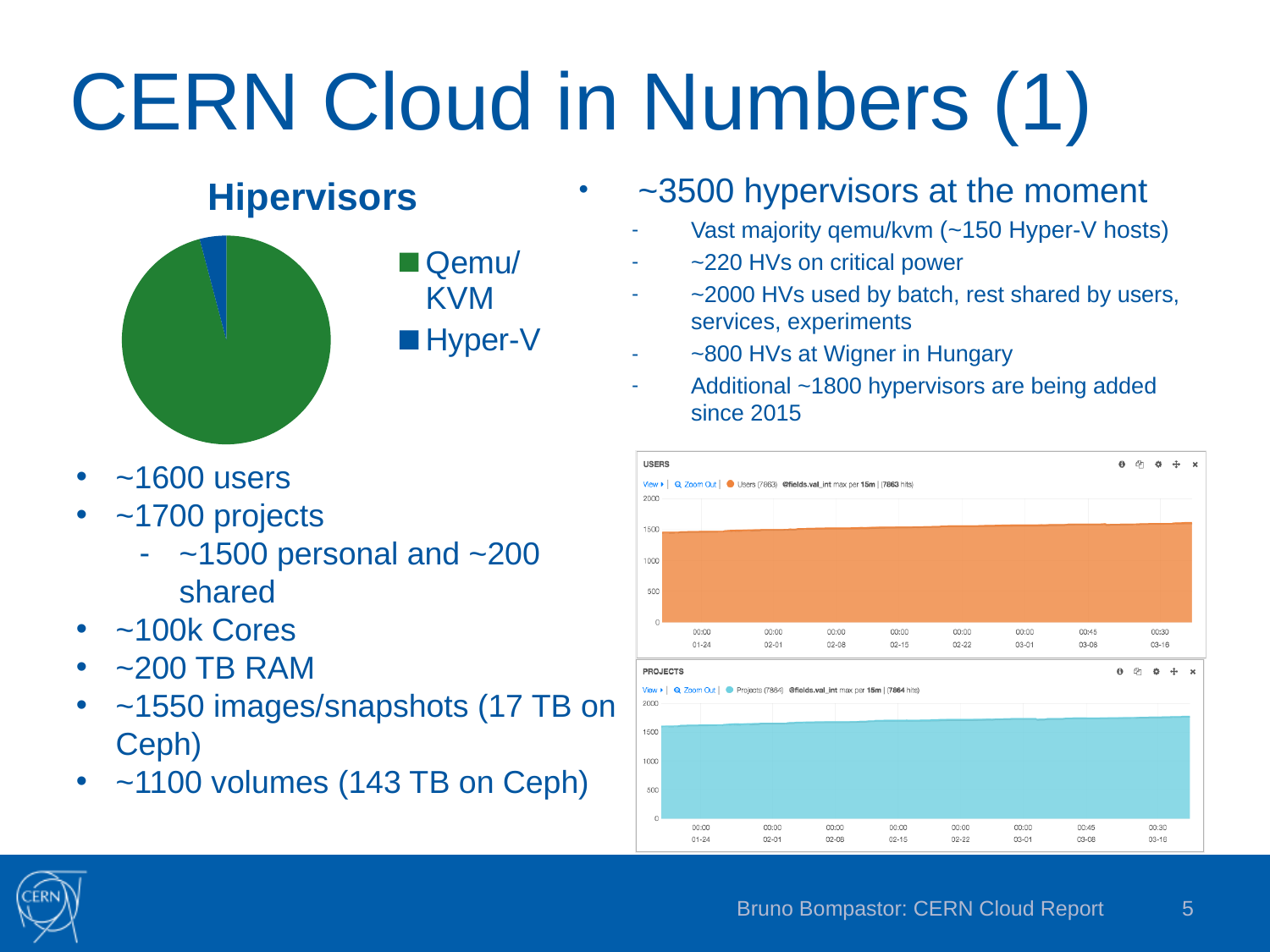
What kind of chart is the "Hipervisors" chart? pie chart In the USERS chart, is the value at the right end of the plotted area greater or less than 1000? greater In the "Hipervisors" pie chart, which category has the smallest slice? Hyper-V In the "Hipervisors" pie chart, what colour is the Hyper-V slice? blue In the "Hipervisors" pie chart, which slice is larger, Qemu/KVM or Hyper-V? Qemu/KVM In the "Hipervisors" pie chart, which category has the largest slice? Qemu/KVM In the USERS chart, is the value at the right end of the plotted area greater or less than 2000? less In the PROJECTS chart, is the value at the right end of the plotted area greater or less than 1000? greater How many entries does the legend of the "Hipervisors" pie chart list? 2 In the USERS chart, do the values rise or fall from left to right along the x axis? rise In the PROJECTS chart, do the values rise or fall from left to right along the x axis? rise What is the title of the pie chart on the slide? Hipervisors